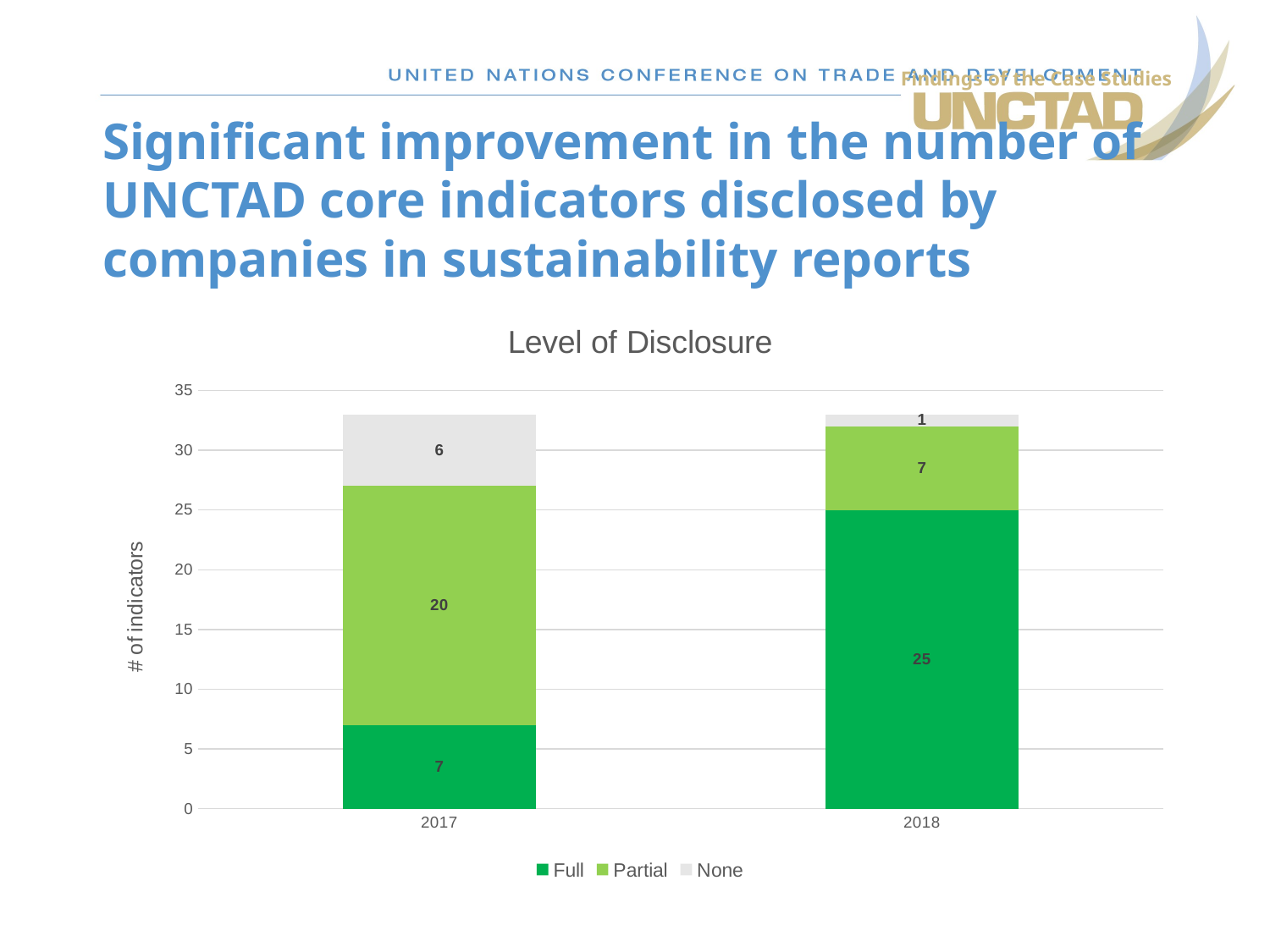
What is the total of the stacked bar for 2018? 33 What is the total of the stacked bar for 2017? 33 Which year has the larger Partial value, 2017 or 2018? 2017 What is the title of the chart? Level of Disclosure What is the difference between the Full values for 2018 and 2017? 18 What kind of chart is shown? Stacked bar chart How many categories are shown on the x axis? 2 What is the value for Full in 2017? 7 What is the value for Full in 2018? 25 How many series does the legend list? 3 What is the value for None in 2017? 6 What is the value for Partial in 2018? 7